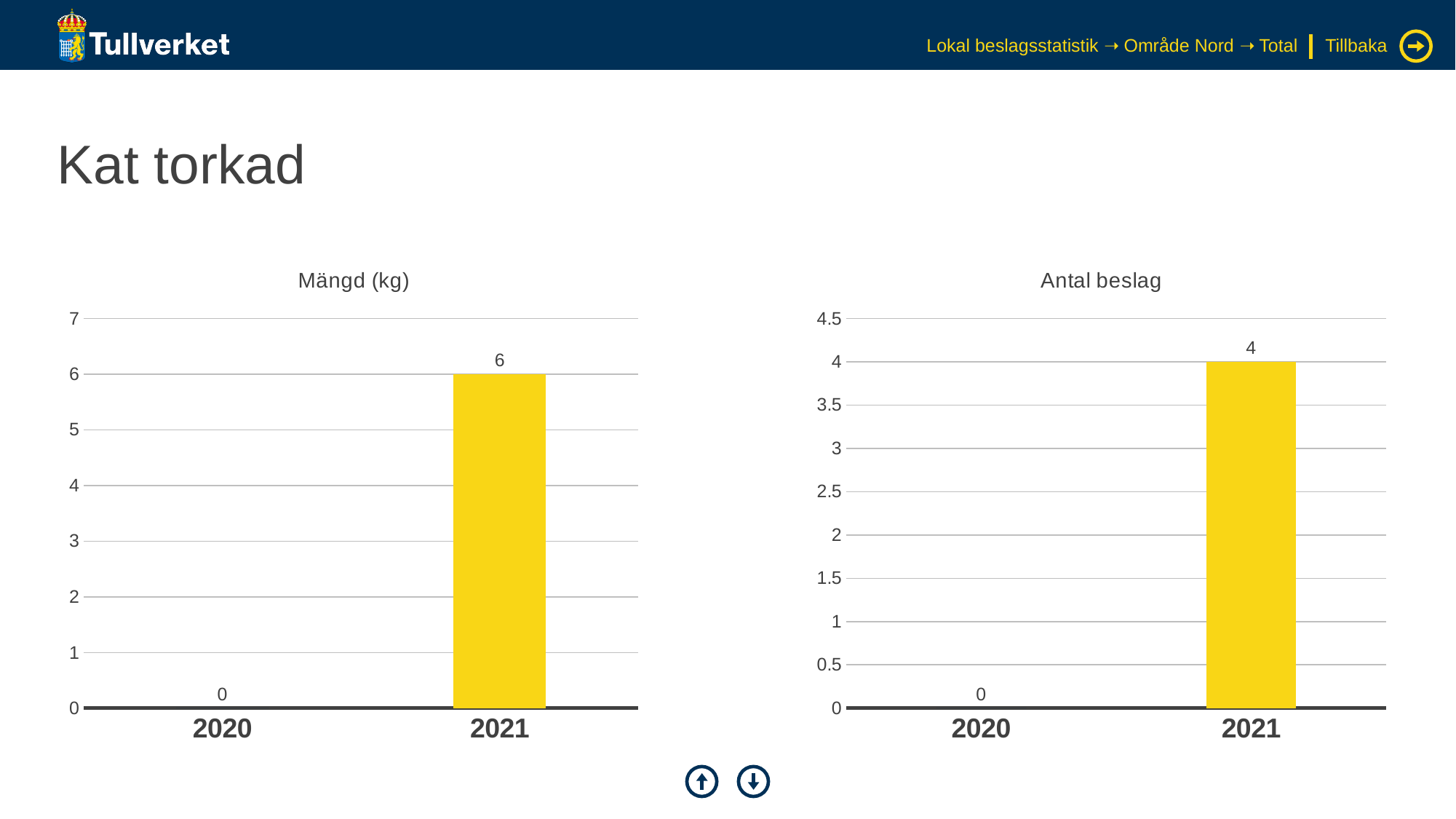
In the 'Antal beslag' chart, what is the value for 2020? 0 How many years are shown on the x axis of the 'Mängd (kg)' chart? 2 In the 'Mängd (kg)' chart, what is the difference between the values for 2021 and 2020? 6 In the 'Antal beslag' chart, which year has the lowest value? 2020 In the 'Antal beslag' chart, is the value for 2021 greater or less than 3? greater In the 'Mängd (kg)' chart, do the values rise or fall from 2020 to 2021? rise What kind of chart is the 'Antal beslag' chart? bar chart In the 'Mängd (kg)' chart, which year has the highest value? 2021 In the 'Mängd (kg)' chart, what is the value for 2020? 0 In the 'Mängd (kg)' chart, what is the value for 2021? 6 In the 'Antal beslag' chart, what is the difference between the values for 2021 and 2020? 4 In the 'Antal beslag' chart, what is the value for 2021? 4